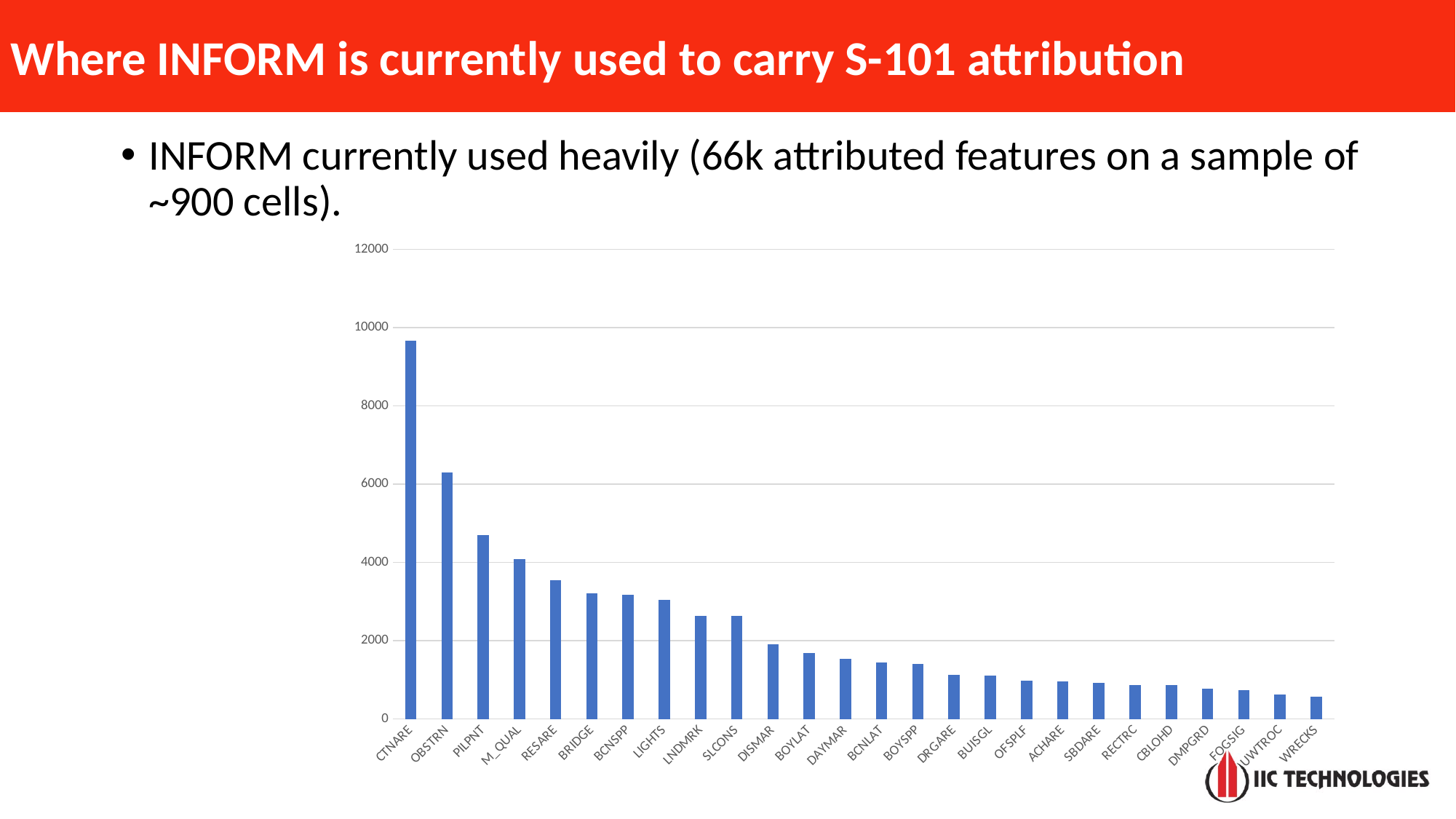
Do the values rise or fall moving from left to right along the x axis? fall What kind of chart is shown on the slide? bar chart Is the value for CTNARE greater or less than 8000? greater Which category has the lowest value in the bar chart? WRECKS Is the value for PILPNT greater or less than 4000? greater Is the value for OBSTRN greater or less than 8000? less Which is larger, the value for OBSTRN or the value for M_QUAL? OBSTRN Which category has the highest value in the bar chart? CTNARE Which is larger, the value for LIGHTS or the value for BOYLAT? LIGHTS How many categories are shown on the x axis of the bar chart? 26